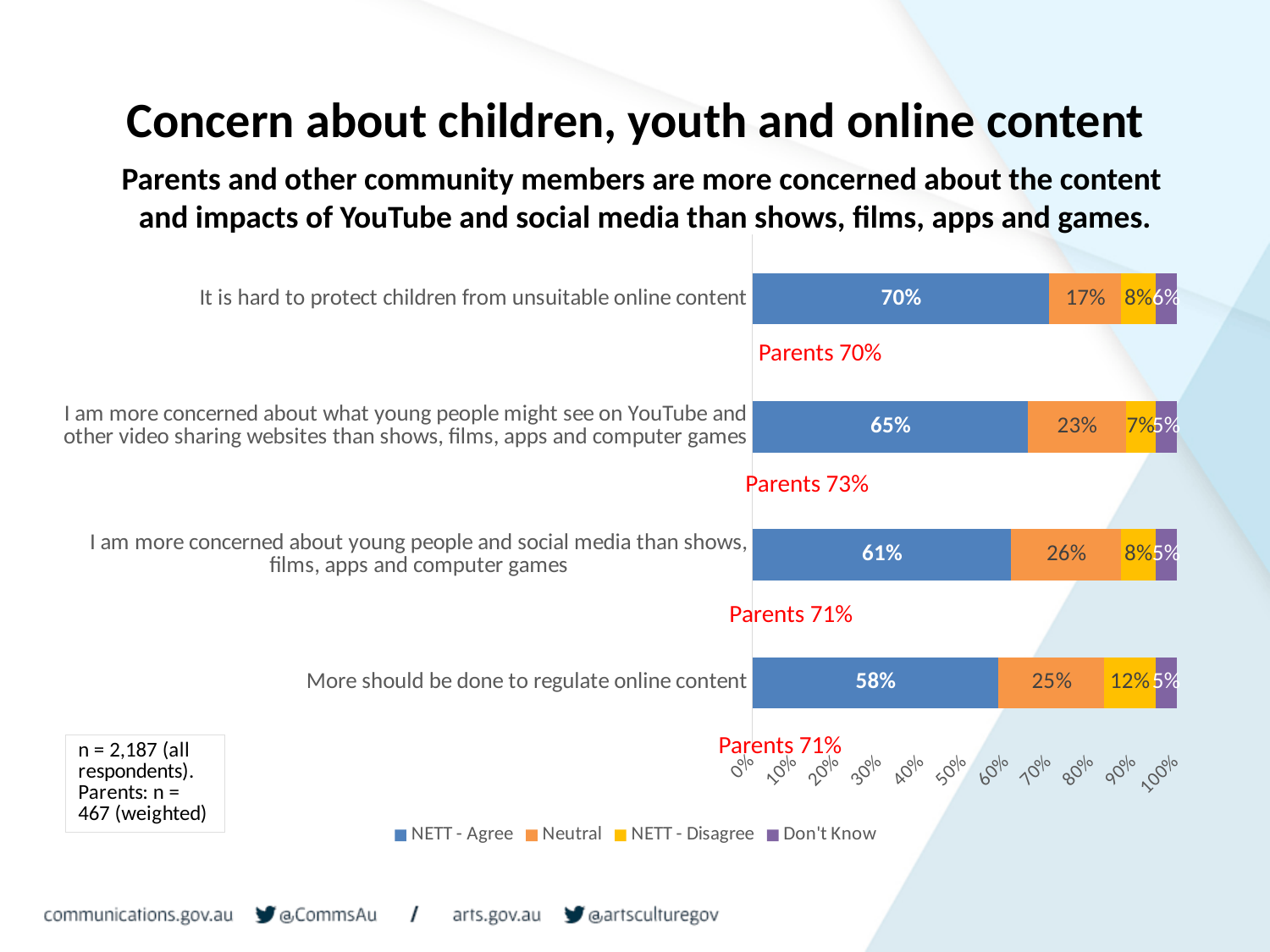
What is the Don't Know value for 'It is hard to protect children from unsuitable online content'? 6% How many statements (categories) are plotted in the chart? 4 Which is larger: the Neutral value for the YouTube statement or the Neutral value for the social media statement? The social media statement (26%) What is the NETT - Disagree value for 'More should be done to regulate online content'? 12% What is the Neutral value for the statement 'I am more concerned about young people and social media than shows, films, apps and computer games'? 26% What kind of chart is shown on the slide? Stacked bar chart What percentage of respondents agree (NETT - Agree) that it is hard to protect children from unsuitable online content? 70% What is the Parents percentage shown for the statement about YouTube and other video sharing websites? 73% What is the difference between the NETT - Agree values for 'It is hard to protect children from unsuitable online content' and 'More should be done to regulate online content'? 12% Which statement has the lowest NETT - Agree value? More should be done to regulate online content Which statement has the highest NETT - Agree value? It is hard to protect children from unsuitable online content How many series does the legend list? 4